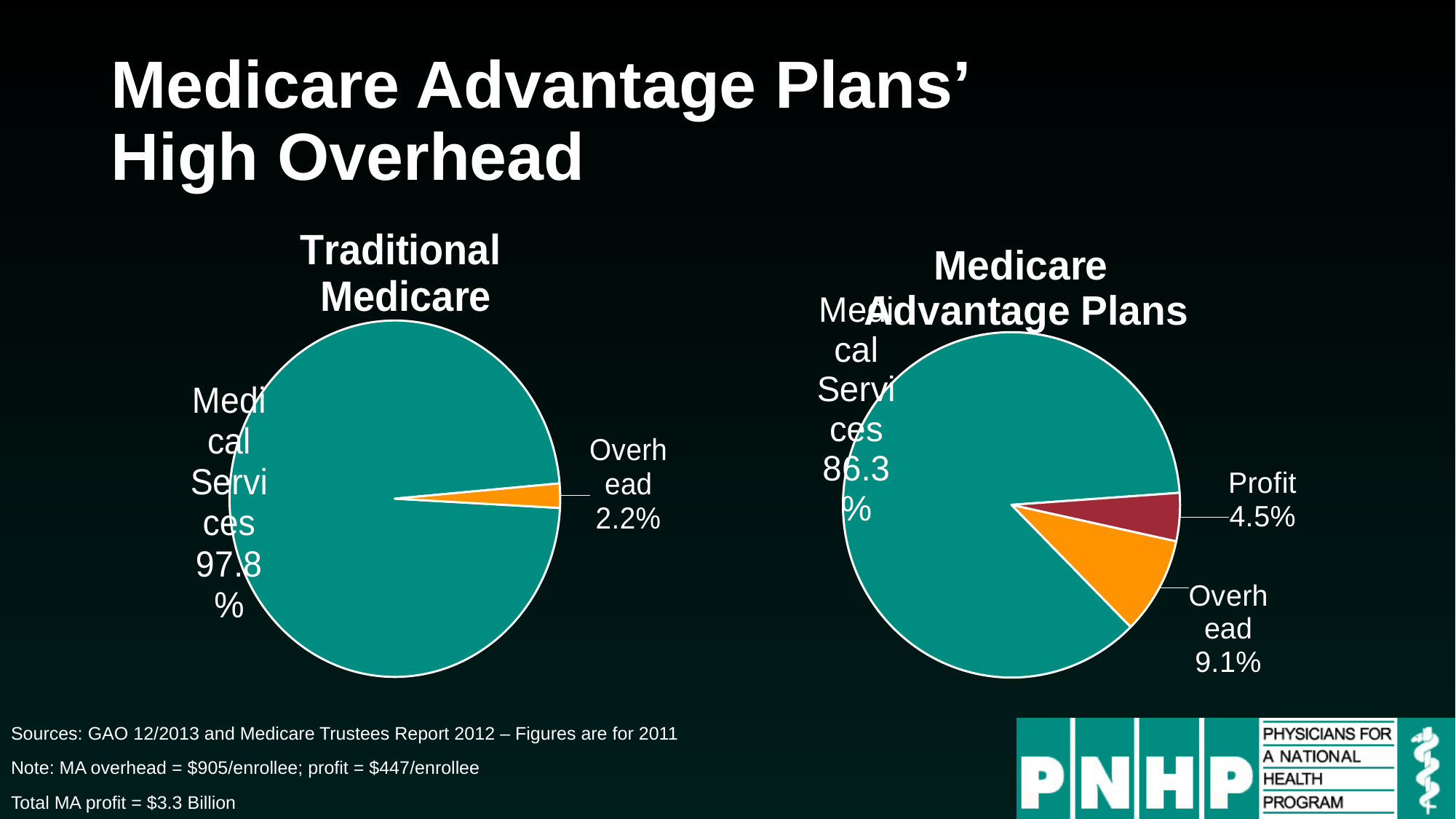
In the Medicare Advantage Plans chart, what is the combined share of Overhead and Profit? 13.6% In the Medicare Advantage Plans chart, which is larger, Overhead or Profit? Overhead In the Medicare Advantage Plans chart, which slice is the smallest? Profit In the Medicare Advantage Plans chart, which slice is the largest? Medical Services In the Traditional Medicare chart, what share of the pie is Medical Services? 97.8% In the Traditional Medicare chart, what share of the pie is Overhead? 2.2% In the Medicare Advantage Plans chart, what share of the pie is Profit? 4.5% What type of chart is the Traditional Medicare chart? Pie chart How many slices does the Medicare Advantage Plans chart have? 3 In the Medicare Advantage Plans chart, what share of the pie is Medical Services? 86.3% What is the difference between the Overhead share in the Medicare Advantage Plans chart and the Overhead share in the Traditional Medicare chart? 6.9% In the Medicare Advantage Plans chart, what share of the pie is Overhead? 9.1%